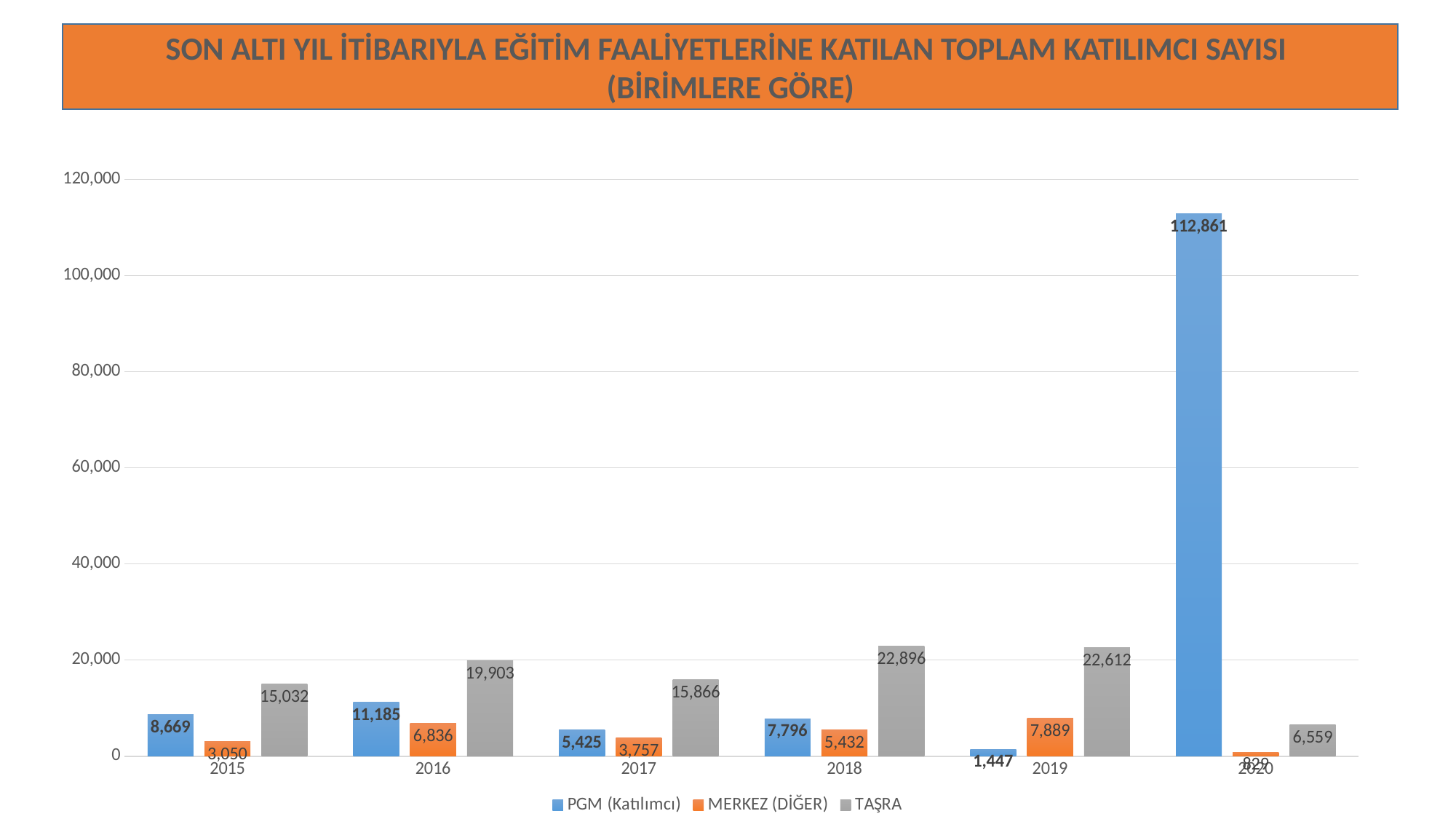
What is the value for MERKEZ (DİĞER) in 2019? 7,889 Is the value for PGM (Katılımcı) in 2020 greater or less than 100,000? greater Which colour represents the TAŞRA series? grey How many years are shown on the x axis? 6 In which year is the PGM (Katılımcı) value highest? 2020 How many series does the legend list? 3 What is the difference between the TAŞRA values for 2016 and 2015? 4,871 What kind of chart is shown on the slide? bar chart What is the value for PGM (Katılımcı) in 2020? 112,861 Which is larger in 2019: MERKEZ (DİĞER) or PGM (Katılımcı)? MERKEZ (DİĞER) What is the value for TAŞRA in 2018? 22,896 In which year is the PGM (Katılımcı) value lowest? 2019